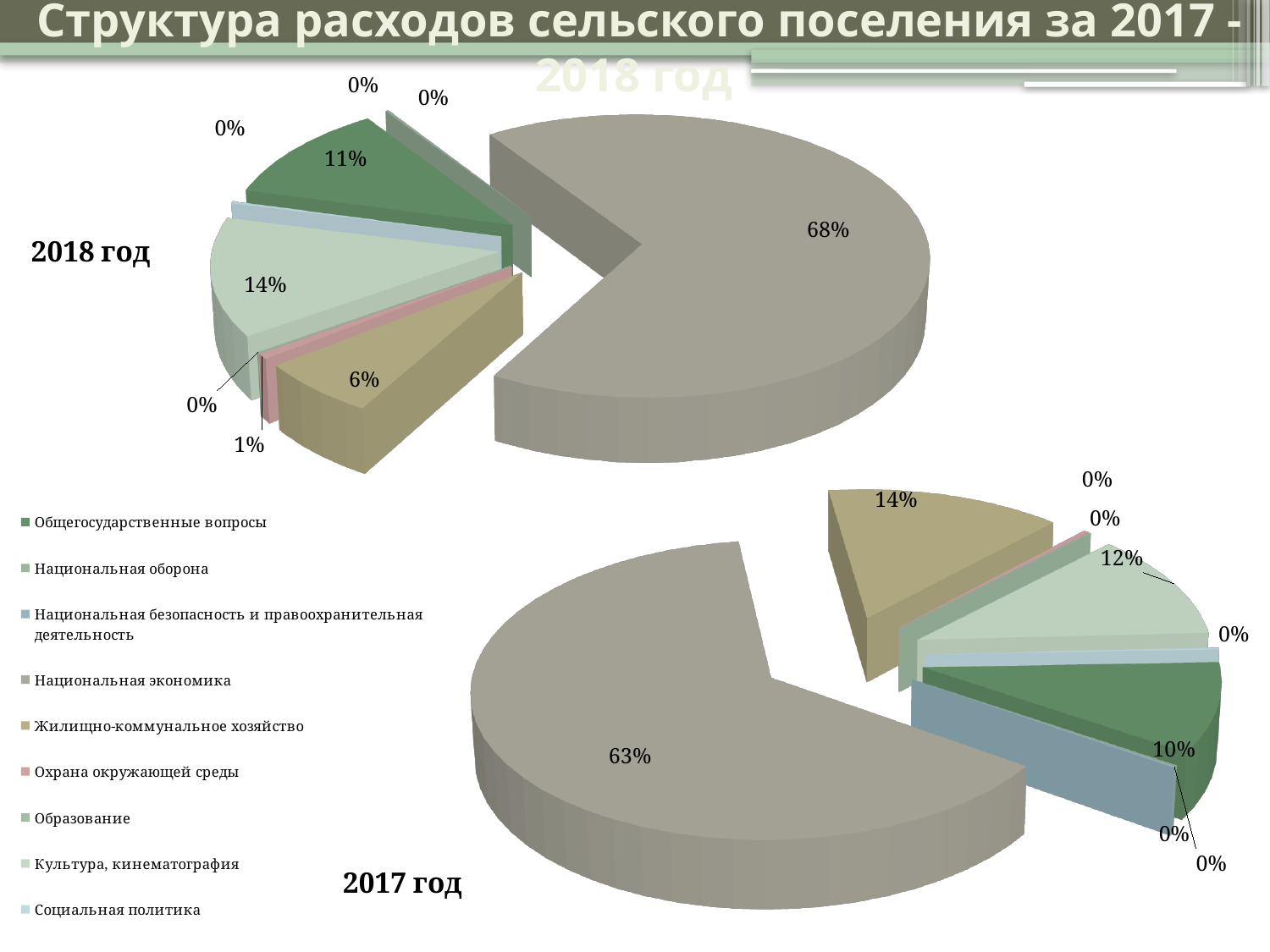
In the 2018 год pie chart, which category has the largest share? Национальная экономика In the 2018 год pie chart, what share is shown for Общегосударственные вопросы? 11% By how many percentage points does the largest slice of the 2018 год chart exceed the largest slice of the 2017 год chart? 5 percentage points In the 2017 год pie chart, what share is shown for Общегосударственные вопросы? 10% In the 2017 год pie chart, what share is shown for Жилищно-коммунальное хозяйство? 14% In the 2018 год pie chart, what percentage is shown for the largest slice? 68% In the 2018 год pie chart, what share is shown for Жилищно-коммунальное хозяйство? 6% What type of charts are shown on the slide? Pie charts Which chart has the larger share for Национальная экономика, 2018 год or 2017 год? 2018 год How many categories does the legend list? 9 In the 2018 год pie chart, what share is shown for Культура, кинематография? 14% In the 2017 год pie chart, what percentage is shown for the largest slice? 63%